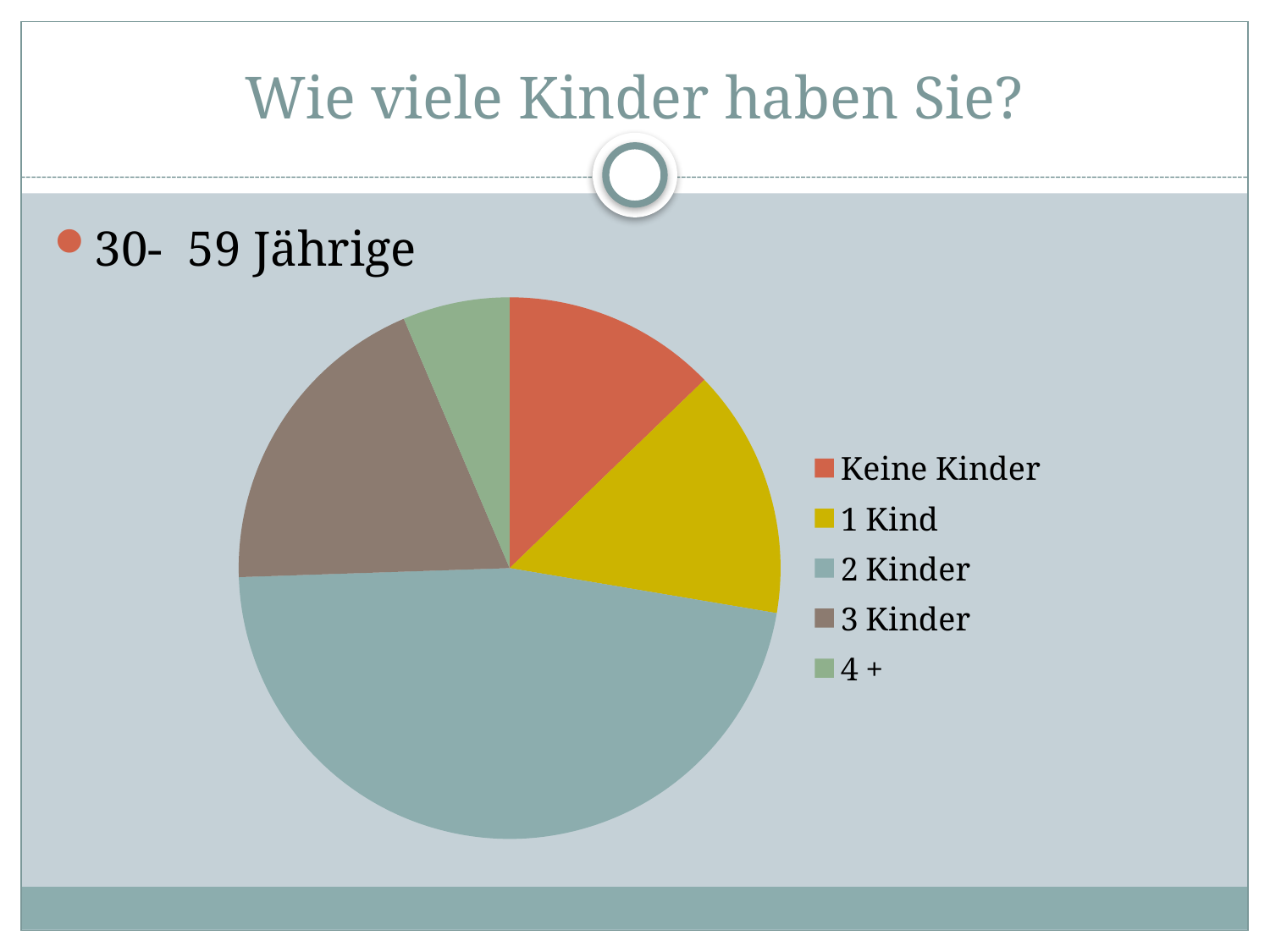
What is the title of the slide containing the pie chart? Wie viele Kinder haben Sie? How many entries does the legend of the pie chart list? 5 Which category has the smallest slice of the pie chart? 4 + Which slice is larger, 3 Kinder or Keine Kinder? 3 Kinder How many slices does the pie chart have? 5 What kind of chart is shown on the slide? pie chart Which category has the largest slice of the pie chart? 2 Kinder Which slice is larger, 1 Kind or 4 +? 1 Kind Which slice is larger, 3 Kinder or 4 +? 3 Kinder Which age group does the pie chart refer to, according to the text above it? 30- 59 Jährige